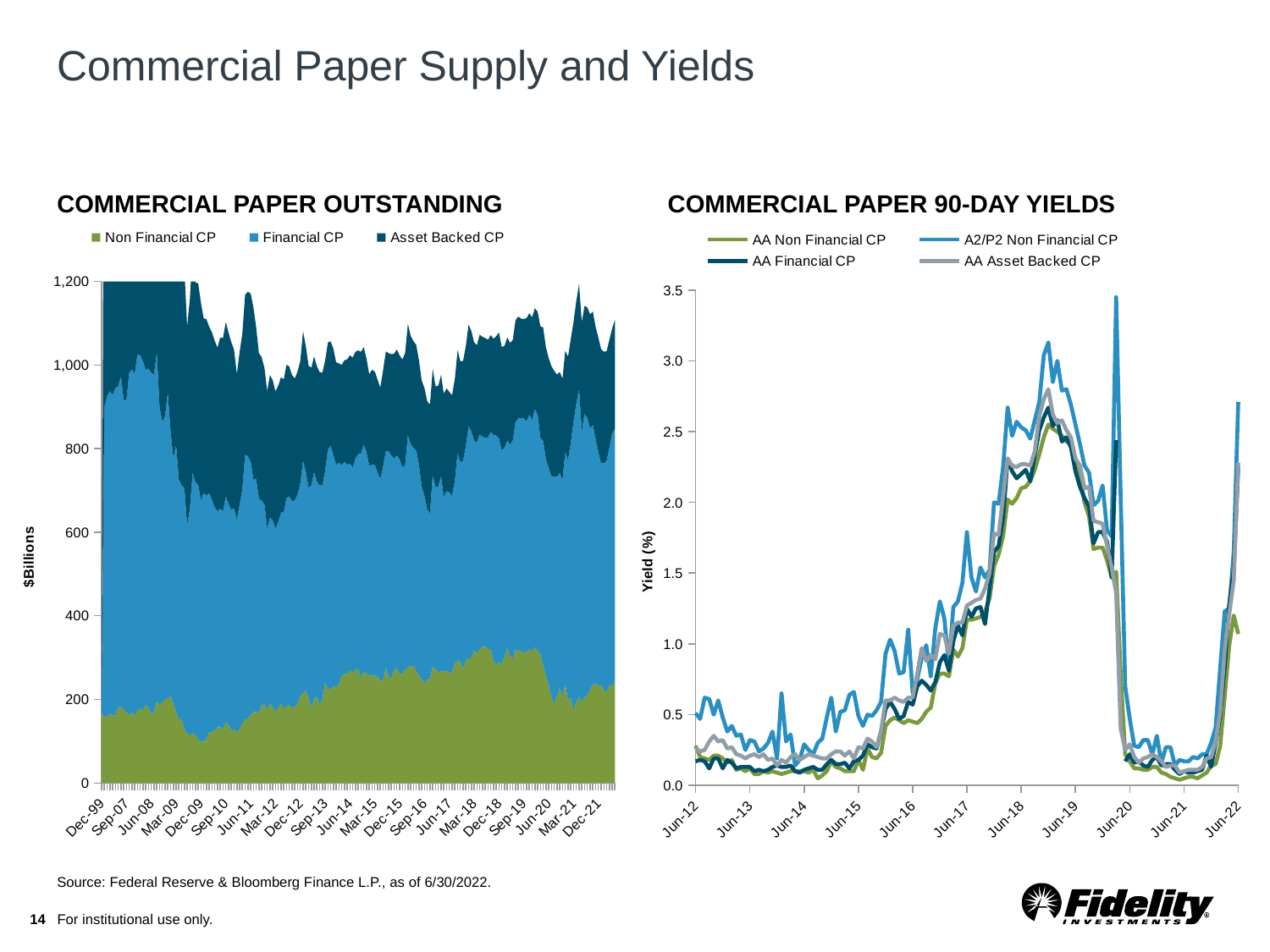
In the COMMERCIAL PAPER 90-DAY YIELDS chart, is the value for AA Non Financial CP at Jun-22 greater or less than 1.5? less What is the y-axis label of the COMMERCIAL PAPER 90-DAY YIELDS chart? Yield (%) How many series does the legend of the COMMERCIAL PAPER OUTSTANDING chart list? 3 In the COMMERCIAL PAPER 90-DAY YIELDS chart, do yields generally rise or fall between Jun-16 and Jun-18? Rise In the COMMERCIAL PAPER OUTSTANDING chart, which series is plotted at the bottom of the stack? Non Financial CP In the COMMERCIAL PAPER 90-DAY YIELDS chart, is the peak value of A2/P2 Non Financial CP around Jun-20 greater or less than 3.0? greater What is the y-axis label of the COMMERCIAL PAPER OUTSTANDING chart? $Billions In the COMMERCIAL PAPER 90-DAY YIELDS chart, which series reaches the highest value around Jun-20? A2/P2 Non Financial CP What kind of chart is the COMMERCIAL PAPER 90-DAY YIELDS chart? Line chart How many series does the legend of the COMMERCIAL PAPER 90-DAY YIELDS chart list? 4 In the COMMERCIAL PAPER OUTSTANDING chart, is the value for Non Financial CP at Dec-21 greater or less than 200? greater What kind of chart is the COMMERCIAL PAPER OUTSTANDING chart? Stacked area chart